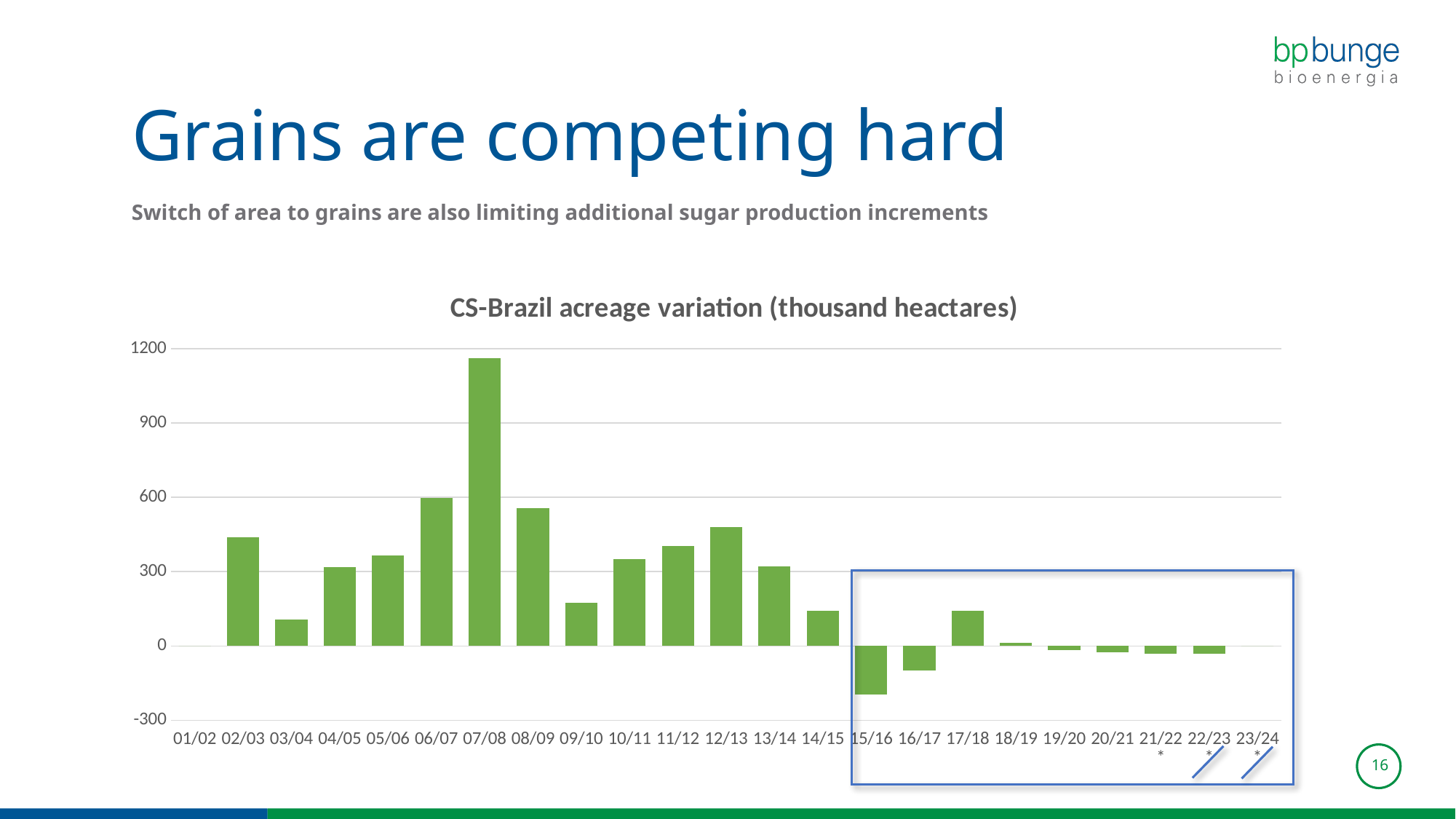
Do the values rise or fall from 07/08 to 09/10? fall What is the title of the chart? CS-Brazil acreage variation (thousand heactares) Is the value for 16/17 greater or less than 0? less Which is larger, the value for 12/13 or the value for 13/14? 12/13 Is the value for 07/08 greater or less than 900? greater What kind of chart is shown on the slide? bar chart Is the value for 03/04 greater or less than 300? less Which season has the highest acreage variation? 07/08 What is the highest value shown on the vertical axis? 1200 Which is larger, the value for 02/03 or the value for 03/04? 02/03 Which season has the lowest (most negative) acreage variation? 15/16